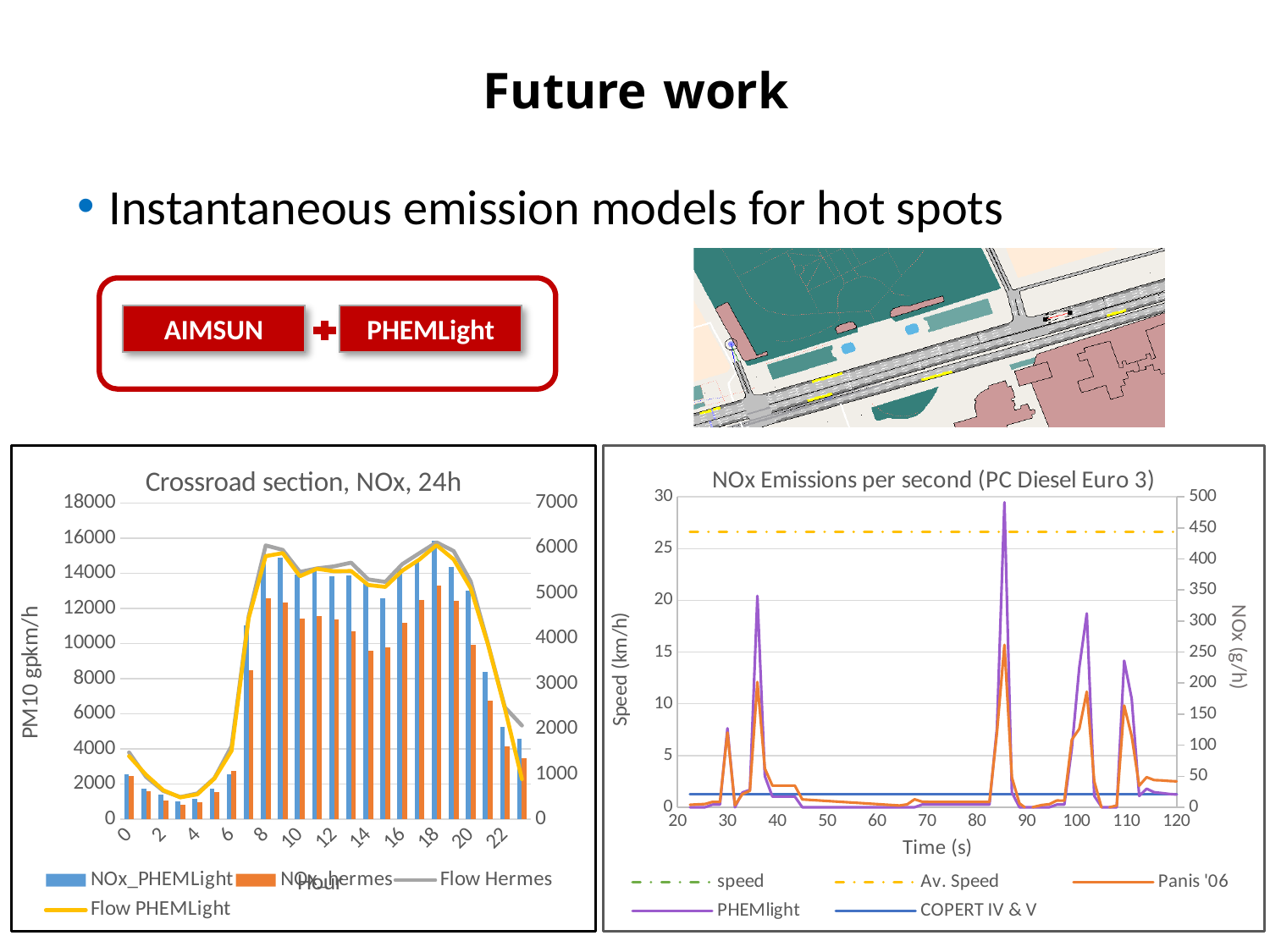
What kind of chart is the right chart (NOx Emissions per second (PC Diesel Euro 3))? Line chart In the left chart (Crossroad section, NOx, 24h), what kind of chart is used to plot the NOx_PHEMLight and NOx_hermes series? Bar chart What is the title of the chart on the right? NOx Emissions per second (PC Diesel Euro 3) In the left chart (Crossroad section, NOx, 24h), how many hours (categories) are plotted along the x axis? 24 In the left chart (Crossroad section, NOx, 24h), is the NOx_PHEMLight value at hour 18 greater or less than 14000? greater In the left chart (Crossroad section, NOx, 24h), at which hour is the NOx_PHEMLight bar highest? 18 In the right chart (NOx Emissions per second), is the Av. Speed line greater or less than 25 km/h on the Speed axis? greater What is the title of the chart on the left? Crossroad section, NOx, 24h In the left chart (Crossroad section, NOx, 24h), is the NOx_hermes value at hour 0 greater or less than 4000? less In the left chart (Crossroad section, NOx, 24h), at hour 8, which is larger: NOx_PHEMLight or NOx_hermes? NOx_PHEMLight How many series does the legend of the left chart (Crossroad section, NOx, 24h) list? 4 How many series does the legend of the right chart (NOx Emissions per second) list? 5